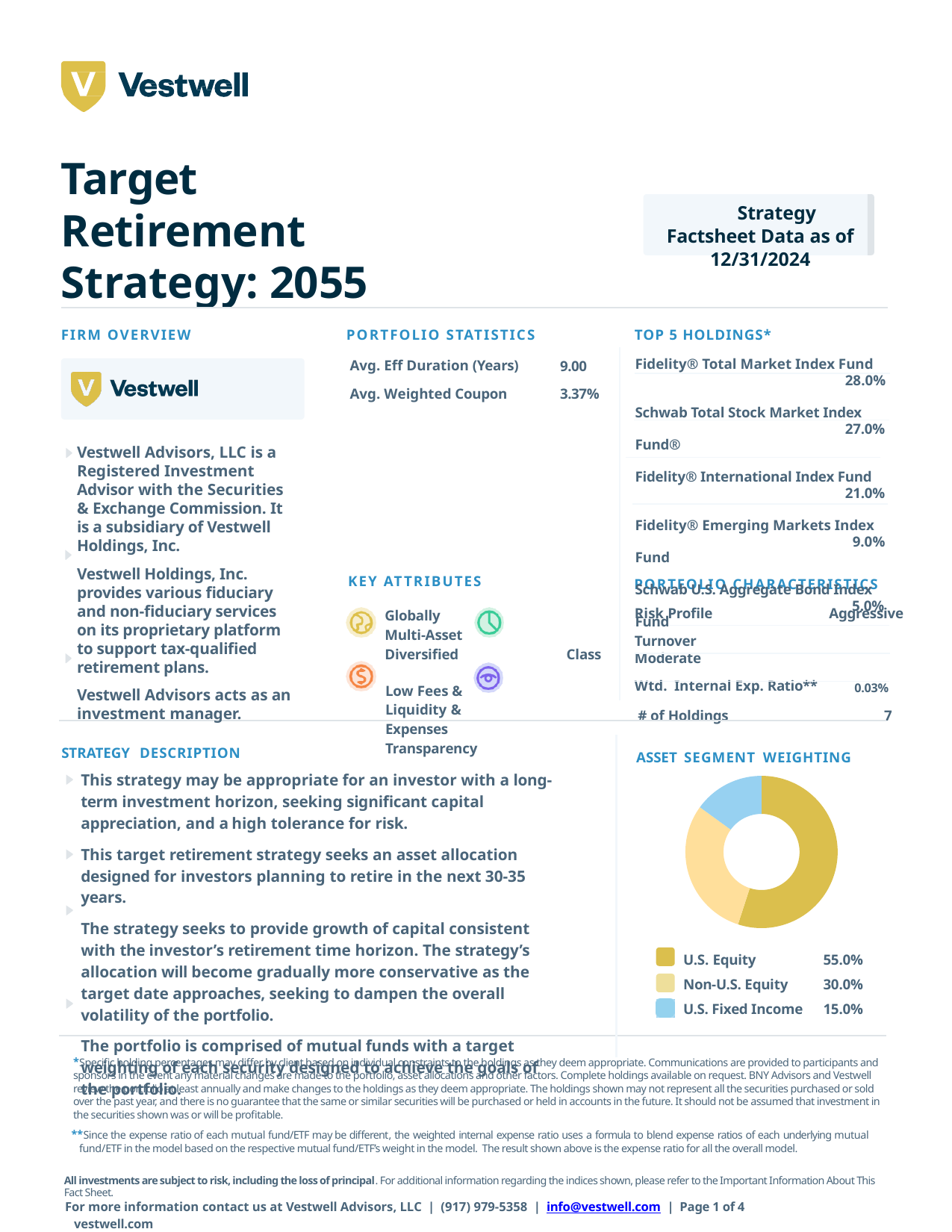
What kind of chart is the Asset Segment Weighting chart? Donut (pie) chart What is the title of the chart on the slide? Asset Segment Weighting In the Asset Segment Weighting chart, what is the value for U.S. Equity? 55.0% In the Asset Segment Weighting chart, what is the difference between U.S. Equity and Non-U.S. Equity? 25.0% Which segment has the smallest share in the Asset Segment Weighting chart? U.S. Fixed Income In the Asset Segment Weighting chart, what colour is the U.S. Fixed Income segment? Light blue In the Asset Segment Weighting chart, what is the value for Non-U.S. Equity? 30.0% In the Asset Segment Weighting chart, what is the value for U.S. Fixed Income? 15.0% In the Asset Segment Weighting chart, what is the combined share of U.S. Equity and Non-U.S. Equity? 85.0% In the Asset Segment Weighting chart, which is larger: Non-U.S. Equity or U.S. Fixed Income? Non-U.S. Equity How many segments does the Asset Segment Weighting chart show? 3 Which segment has the largest share in the Asset Segment Weighting chart? U.S. Equity